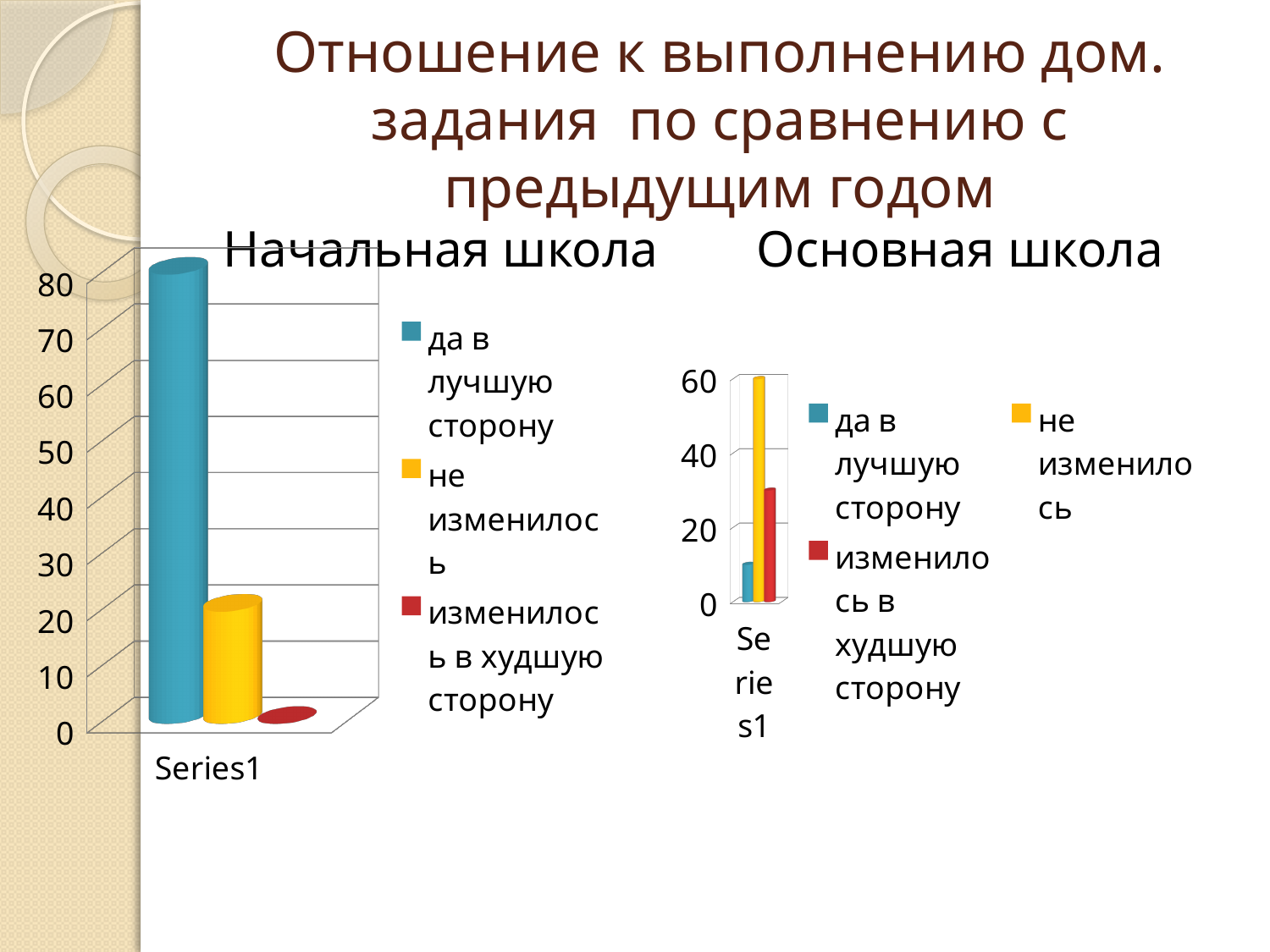
In the "Основная школа" chart, which is larger: "не изменилось" or "да в лучшую сторону"? не изменилось In the "Начальная школа" chart, is the value for "да в лучшую сторону" greater or less than 70? greater What kind of chart is the "Начальная школа" chart? bar chart In the "Основная школа" chart, how many series does the legend list? 3 In the "Основная школа" chart, is the value for "изменилось в худшую сторону" greater or less than 40? less In the "Начальная школа" chart, which series has the lowest bar? изменилось в худшую сторону In the "Начальная школа" chart, which series has the highest bar? да в лучшую сторону In the "Начальная школа" chart, how many series does the legend list? 3 In the "Основная школа" chart, which series has the highest bar? не изменилось In the "Основная школа" chart, which series has the lowest bar? да в лучшую сторону In the "Начальная школа" chart, is the value for "не изменилось" greater or less than 30? less What kind of chart is the "Основная школа" chart? bar chart